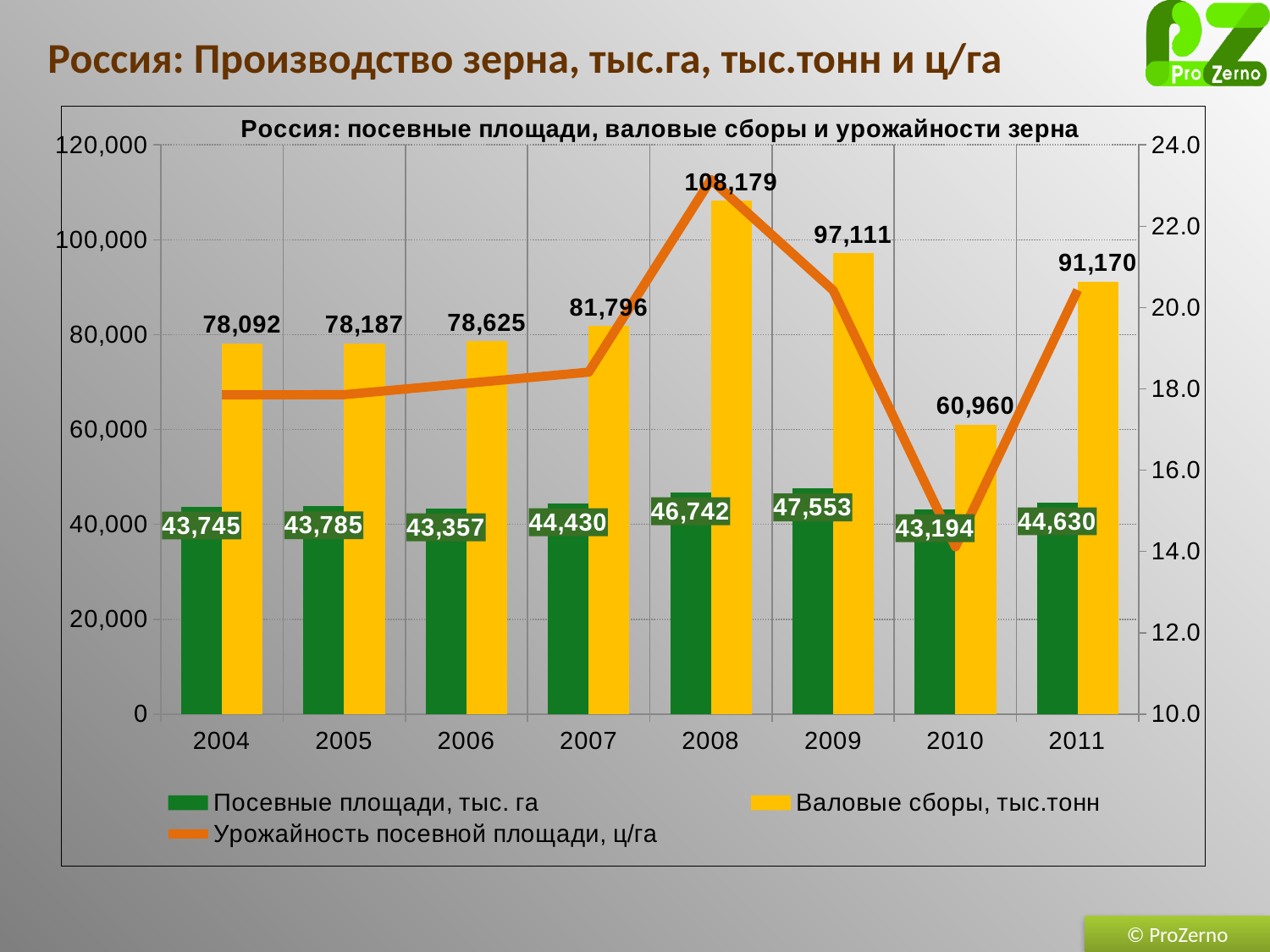
In which year is Валовые сборы, тыс.тонн the lowest? 2010 What kind of chart is this? A bar chart combined with a line chart In which year is Валовые сборы, тыс.тонн the highest? 2008 What is the value of Посевные площади, тыс. га for 2009? 47,553 How many years are shown on the x axis? 8 What is the value of Валовые сборы, тыс.тонн for 2011? 91,170 Which year has the larger Посевные площади, тыс. га: 2007 or 2008? 2008 What is the value of Валовые сборы, тыс.тонн for 2008? 108,179 What is the difference between Валовые сборы, тыс.тонн in 2008 and 2009? 11,068 How many series does the legend list? 3 Is the value of Урожайность посевной площади, ц/га for 2010 greater or less than 16.0? less In which year is Посевные площади, тыс. га the lowest? 2010